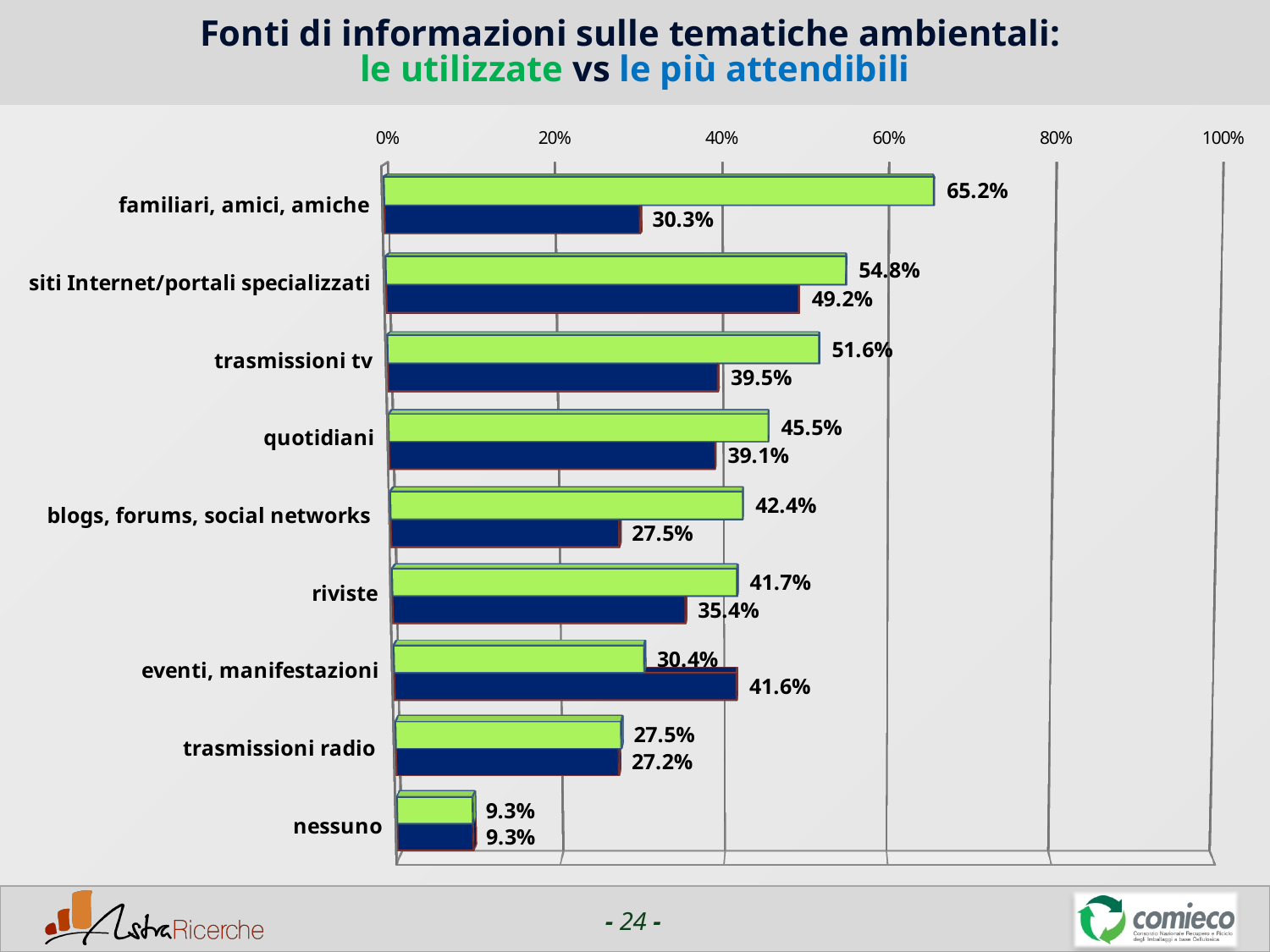
Which category has the lowest value among the blue bars (le più attendibili)? nessuno For 'eventi, manifestazioni', which bar is larger: the green bar (le utilizzate) or the blue bar (le più attendibili)? the blue bar (le più attendibili) How many categories are shown on the chart? 9 What type of chart is shown on the slide? bar chart What is the value of the blue bar (le più attendibili) for 'siti Internet/portali specializzati'? 49.2% What is the difference between the green bar and the blue bar for 'familiari, amici, amiche'? 34.9% What is the value of the green bar (le utilizzate) for 'familiari, amici, amiche'? 65.2% Which category has the highest value among the green bars (le utilizzate)? familiari, amici, amiche Is the blue bar (le più attendibili) for 'quotidiani' greater or less than 40%? less What is the title of the chart on the slide? Fonti di informazioni sulle tematiche ambientali: le utilizzate vs le più attendibili What is the value of the blue bar (le più attendibili) for 'eventi, manifestazioni'? 41.6% What is the difference between the green bar and the blue bar for 'trasmissioni tv'? 12.1%